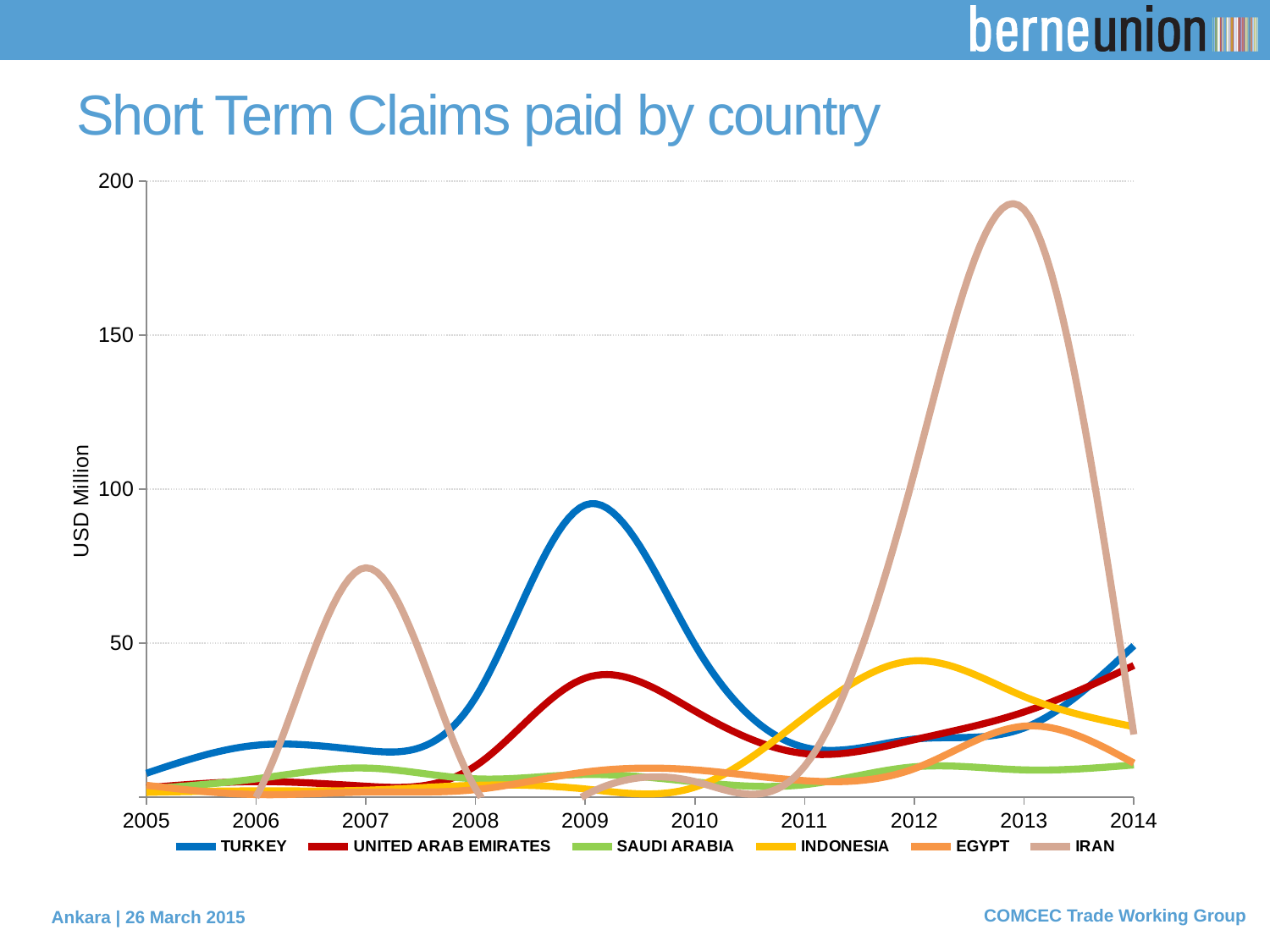
Is the value for IRAN in 2013 greater or less than 150? greater In 2009, which is larger: the value for TURKEY or for UNITED ARAB EMIRATES? TURKEY What kind of chart is shown on the slide? line chart Is the value for TURKEY in 2009 greater or less than 50? greater Which country reaches the highest value on the chart? IRAN In which year does the IRAN line reach its peak? 2013 How many series does the legend list? 6 What is the label on the y axis? USD Million Is the value for UNITED ARAB EMIRATES in 2009 greater or less than 50? less Does the TURKEY line rise or fall from 2011 to 2014? rise In which year does the TURKEY line reach its peak? 2009 How many years are shown along the x axis? 10